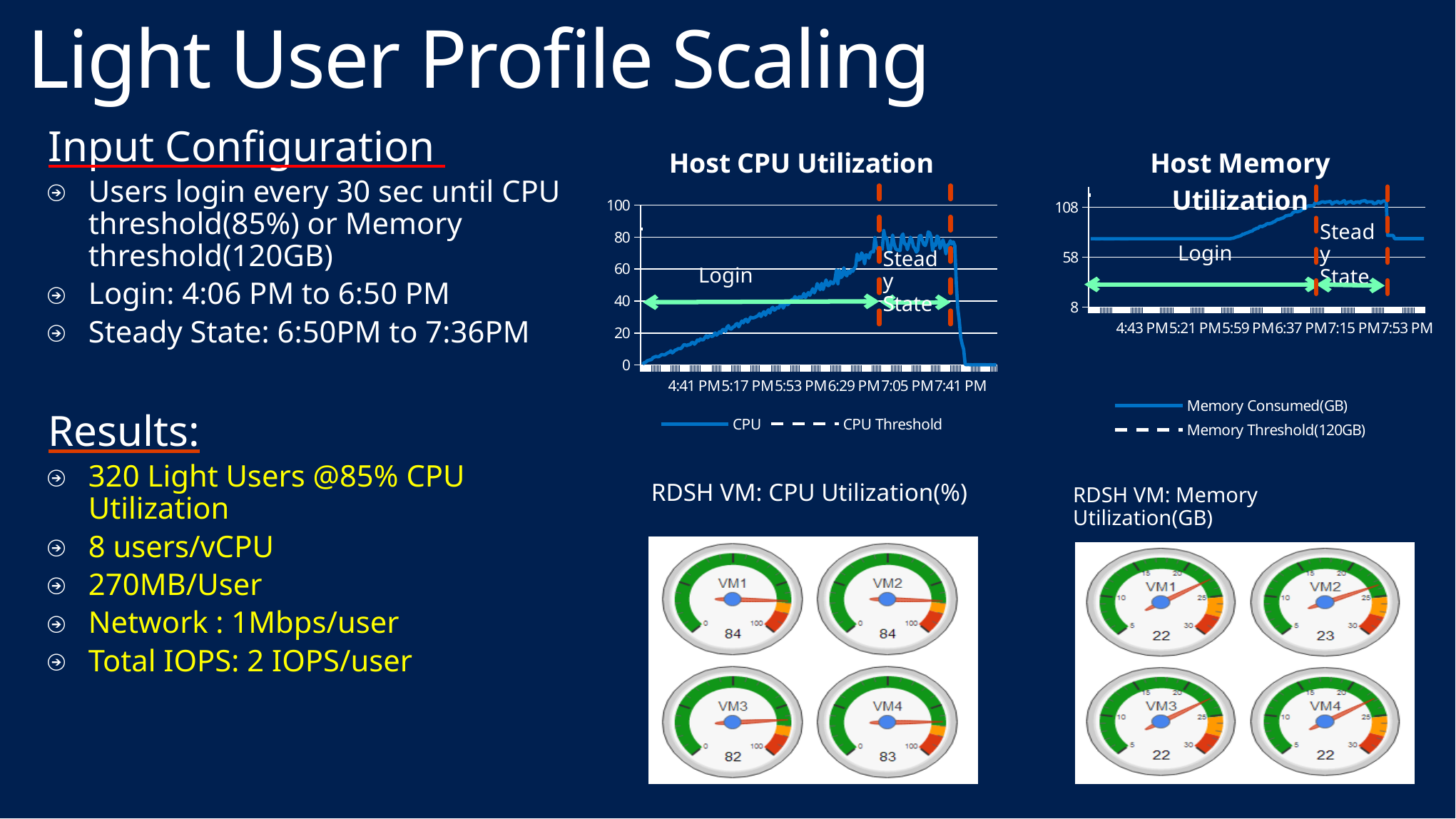
How many series does the legend of the Host CPU Utilization chart list? 2 In the RDSH VM: Memory Utilization(GB) gauges, what is the value shown for VM2? 23 In the RDSH VM: CPU Utilization(%) gauges, what is the value shown for VM3? 82 How many gauges are shown in the RDSH VM: CPU Utilization(%) panel? 4 In the RDSH VM: Memory Utilization(GB) gauges, which VM shows the highest value? VM2 In the Host Memory Utilization chart, does the Memory Consumed line rise or fall during the Login phase? rise What are the two legend entries of the Host Memory Utilization chart? Memory Consumed(GB) and Memory Threshold(120GB) In the RDSH VM: CPU Utilization(%) gauges, what is the difference between the VM1 and VM3 values? 2 What kind of chart is the Host CPU Utilization chart? line chart In the RDSH VM: CPU Utilization(%) gauges, which VM shows the lowest value? VM3 In the RDSH VM: CPU Utilization(%) gauges, which is larger, the value for VM4 or the value for VM3? VM4